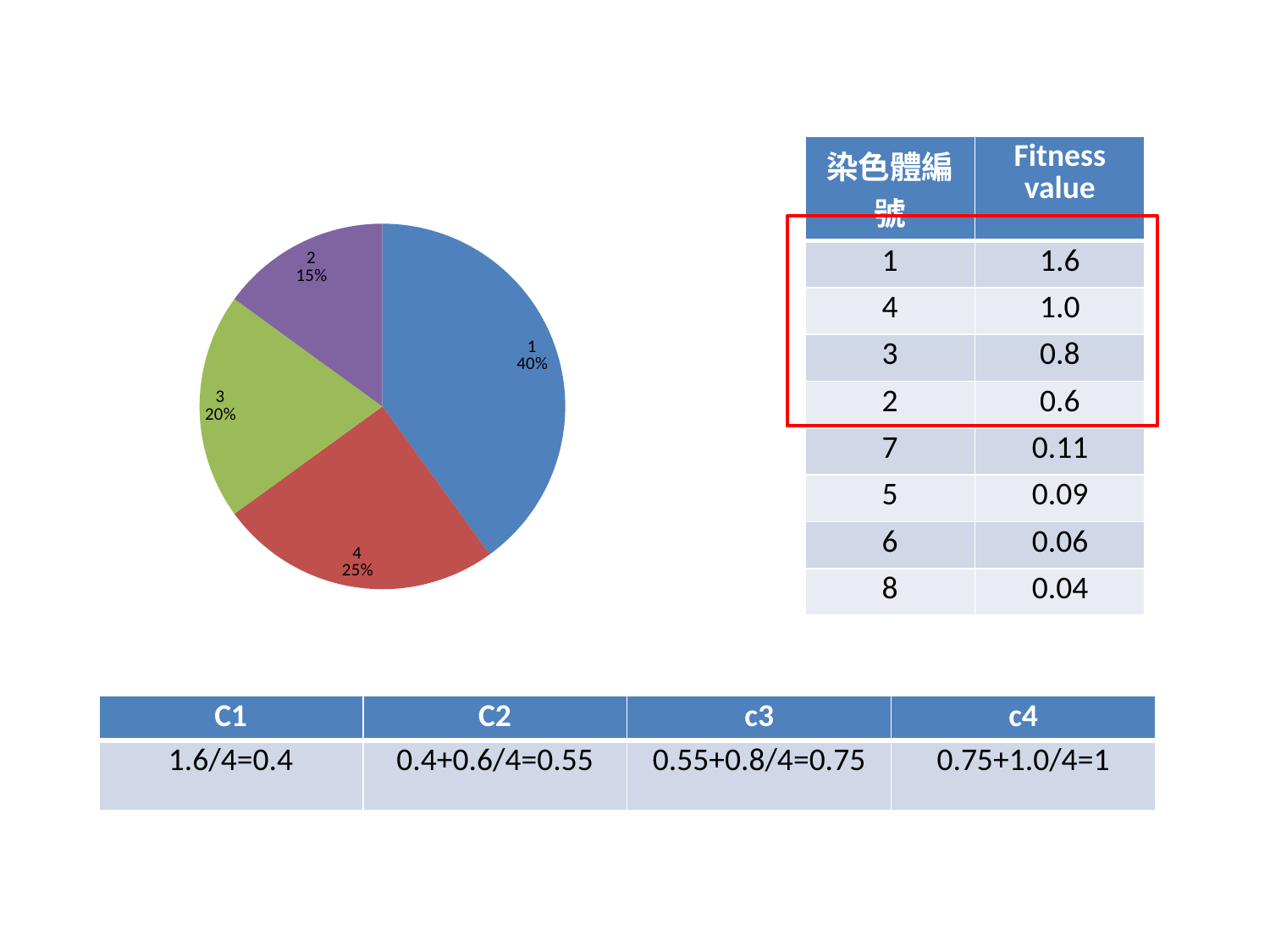
What colour is the slice labelled 1 in the pie chart? blue What percentage share does slice 1 have in the pie chart? 40% What percentage share does slice 2 have in the pie chart? 15% What percentage share does slice 4 have in the pie chart? 25% Which slice has the smallest share of the pie chart? 2 What kind of chart is shown on the slide? pie chart Which slice has the largest share of the pie chart? 1 How many slices does the pie chart have? 4 What percentage share does slice 3 have in the pie chart? 20% What is the difference in percentage points between slice 1 and slice 2 in the pie chart? 25 What is the difference in percentage points between slice 4 and slice 3 in the pie chart? 5 Which slice is larger in the pie chart, slice 3 or slice 4? 4